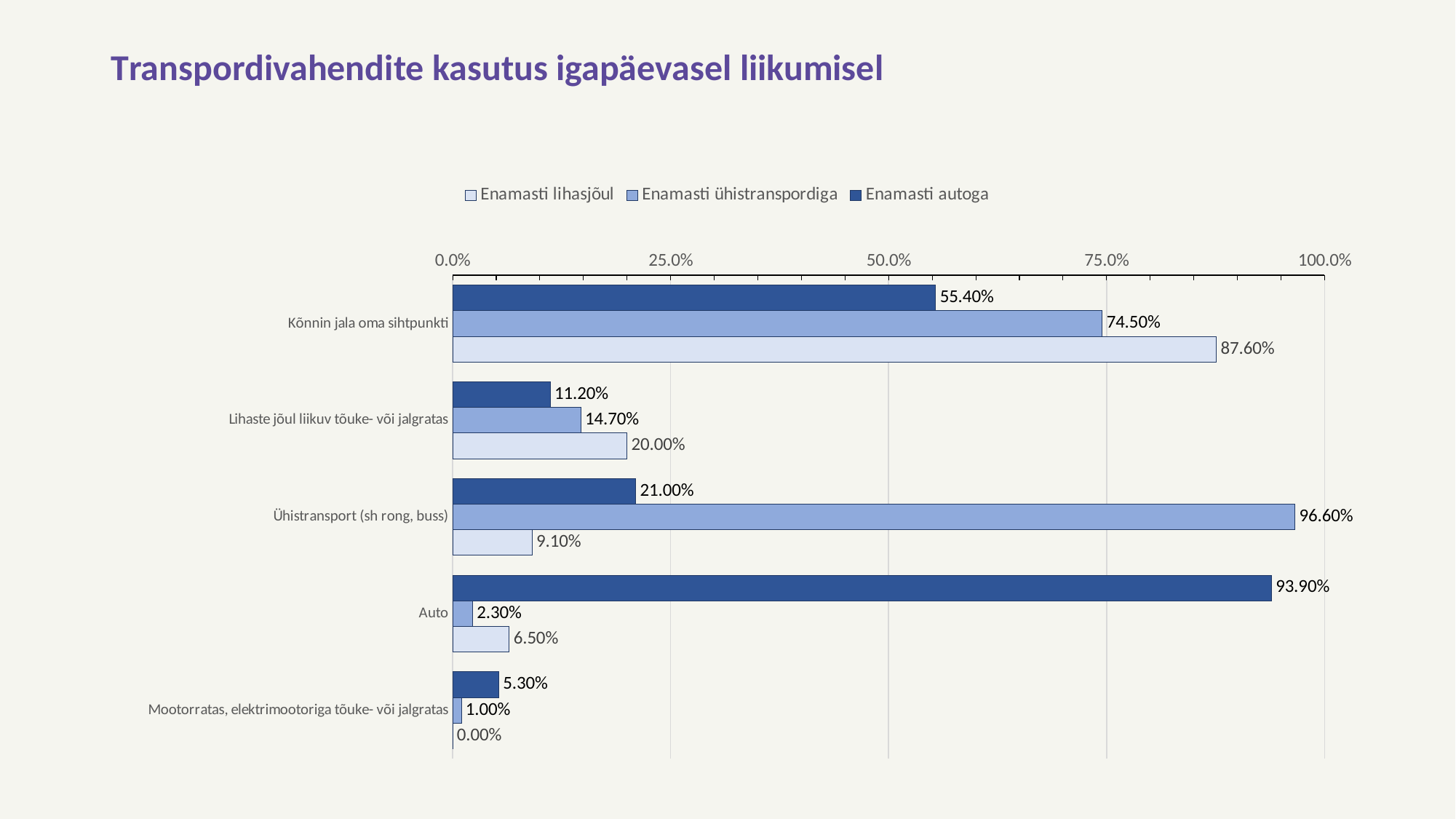
What kind of chart is shown on the slide? Bar chart What is the difference between the 'Enamasti lihasjõul' and 'Enamasti autoga' values in the 'Kõnnin jala oma sihtpunkti' category? 32.20% Is the value for 'Enamasti ühistranspordiga' in the 'Kõnnin jala oma sihtpunkti' category greater or less than 50.0%? greater Which category has the lowest value for the 'Enamasti lihasjõul' series? Mootorratas, elektrimootoriga tõuke- või jalgratas In the 'Lihaste jõul liikuv tõuke- või jalgratas' category, which is larger: 'Enamasti lihasjõul' or 'Enamasti autoga'? Enamasti lihasjõul What is the value for 'Enamasti ühistranspordiga' in the 'Ühistransport (sh rong, buss)' category? 96.60% How many series does the legend list? 3 Which category has the highest value for the 'Enamasti autoga' series? Auto How many categories are shown on the chart? 5 What is the value for 'Enamasti autoga' in the 'Auto' category? 93.90% What is the value for 'Enamasti ühistranspordiga' in the 'Mootorratas, elektrimootoriga tõuke- või jalgratas' category? 1.00% What is the value for 'Enamasti lihasjõul' in the 'Kõnnin jala oma sihtpunkti' category? 87.60%